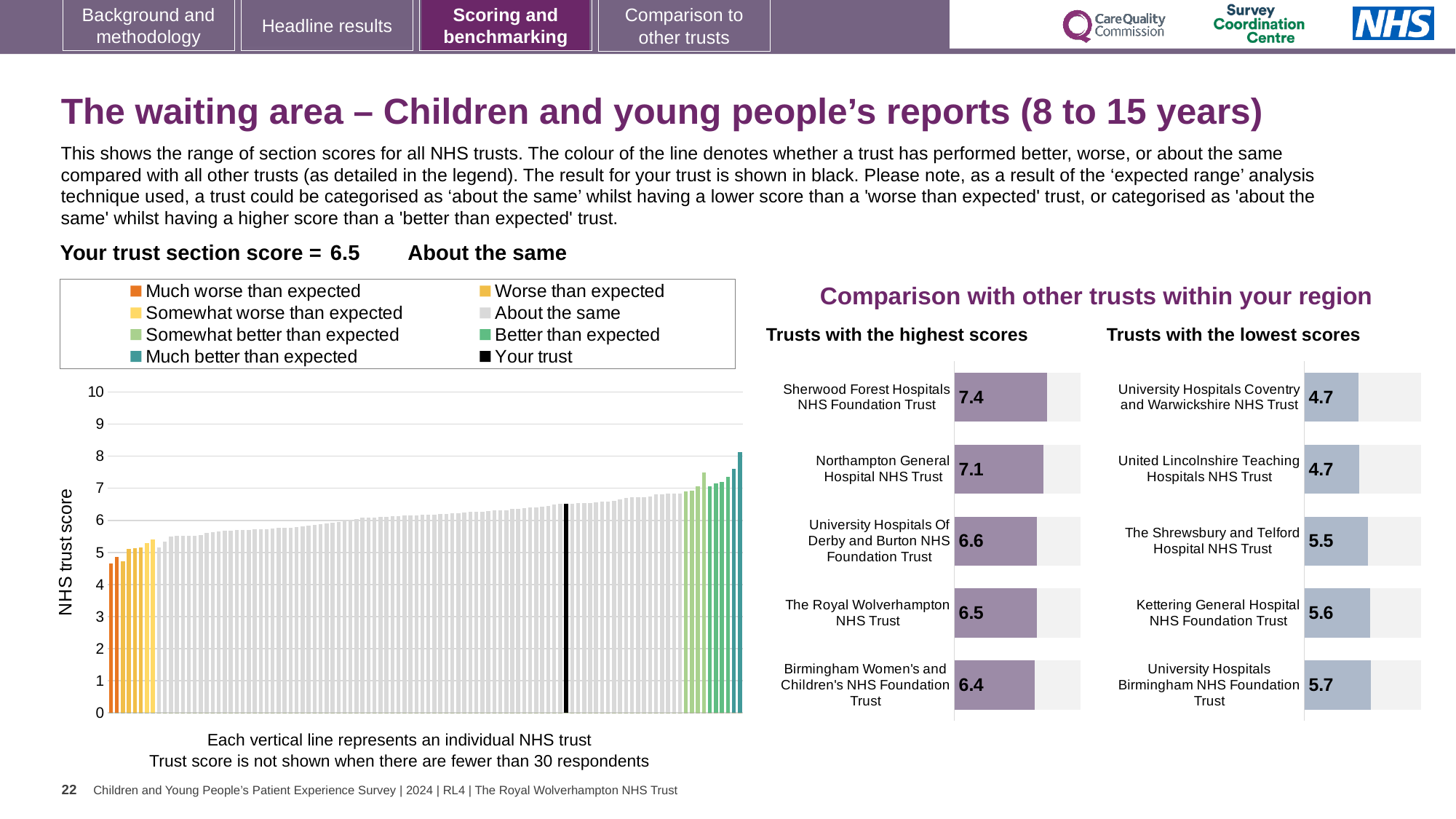
How many entries does the legend above the large chart on the left list? 8 What kind of chart is the large chart on the left showing NHS trust scores? bar chart In the large chart on the left, is the value of the lowest (leftmost) bar greater or less than 5? less What is the y-axis label of the large chart on the left? NHS trust score In the 'Trusts with the highest scores' chart, which trust has the lowest score? Birmingham Women's and Children's NHS Foundation Trust In the large chart on the left, do the bar values rise or fall from left to right? rise In the 'Trusts with the lowest scores' chart, which has the larger score: Kettering General Hospital NHS Foundation Trust or The Shrewsbury and Telford Hospital NHS Trust? Kettering General Hospital NHS Foundation Trust In the 'Trusts with the highest scores' chart, what is the difference between the scores of Sherwood Forest Hospitals NHS Foundation Trust and Birmingham Women's and Children's NHS Foundation Trust? 1.0 In the 'Trusts with the highest scores' chart, what is the score for Sherwood Forest Hospitals NHS Foundation Trust? 7.4 How many trusts are shown in the 'Trusts with the lowest scores' chart? 5 In the 'Trusts with the lowest scores' chart, which trust has the highest score? University Hospitals Birmingham NHS Foundation Trust In the large chart on the left, what is the section score for your trust (the black bar)? 6.5